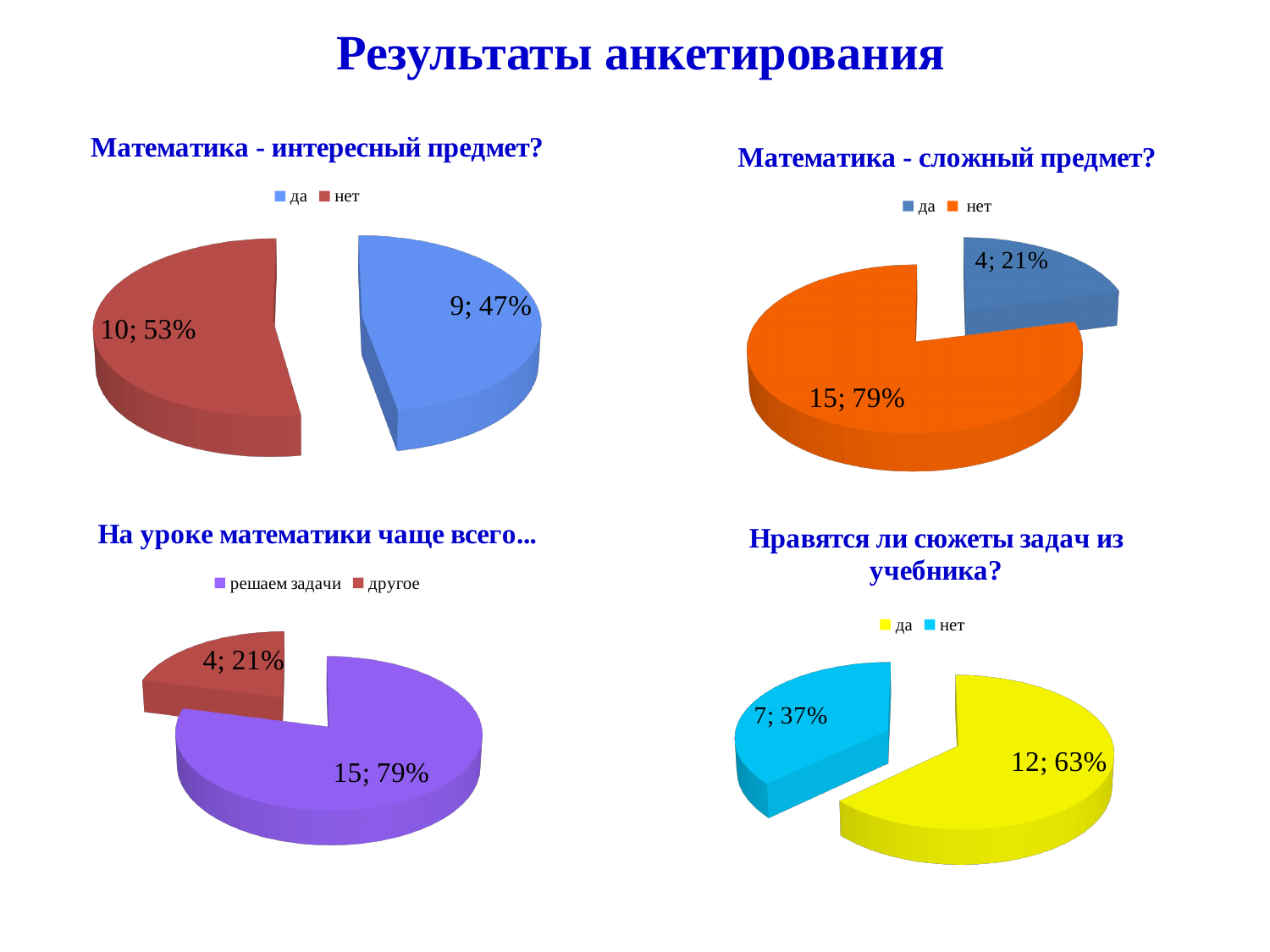
In the chart titled "На уроке математики чаще всего...", what is the value for "решаем задачи"? 15 In the chart titled "Нравятся ли сюжеты задач из учебника?", what share of the pie is "да"? 63% How many entries does the legend of the chart titled "На уроке математики чаще всего..." list? 2 In the chart titled "Математика - интересный предмет?", how many respondents answered "да"? 9 In the chart titled "Математика - сложный предмет?", what is the value for "нет"? 15 In the chart titled "Математика - сложный предмет?", what share of the pie is "да"? 21% In the chart titled "Математика - интересный предмет?", what share of the pie is "нет"? 53% What kind of chart is the one titled "Математика - интересный предмет?"? pie chart In the chart titled "Математика - сложный предмет?", which category is the largest? нет In the chart titled "На уроке математики чаще всего...", what is the difference between "решаем задачи" and "другое"? 11 In the chart titled "Нравятся ли сюжеты задач из учебника?", what is the total of all slices? 19 In the chart titled "Нравятся ли сюжеты задач из учебника?", which is larger, "да" or "нет"? да